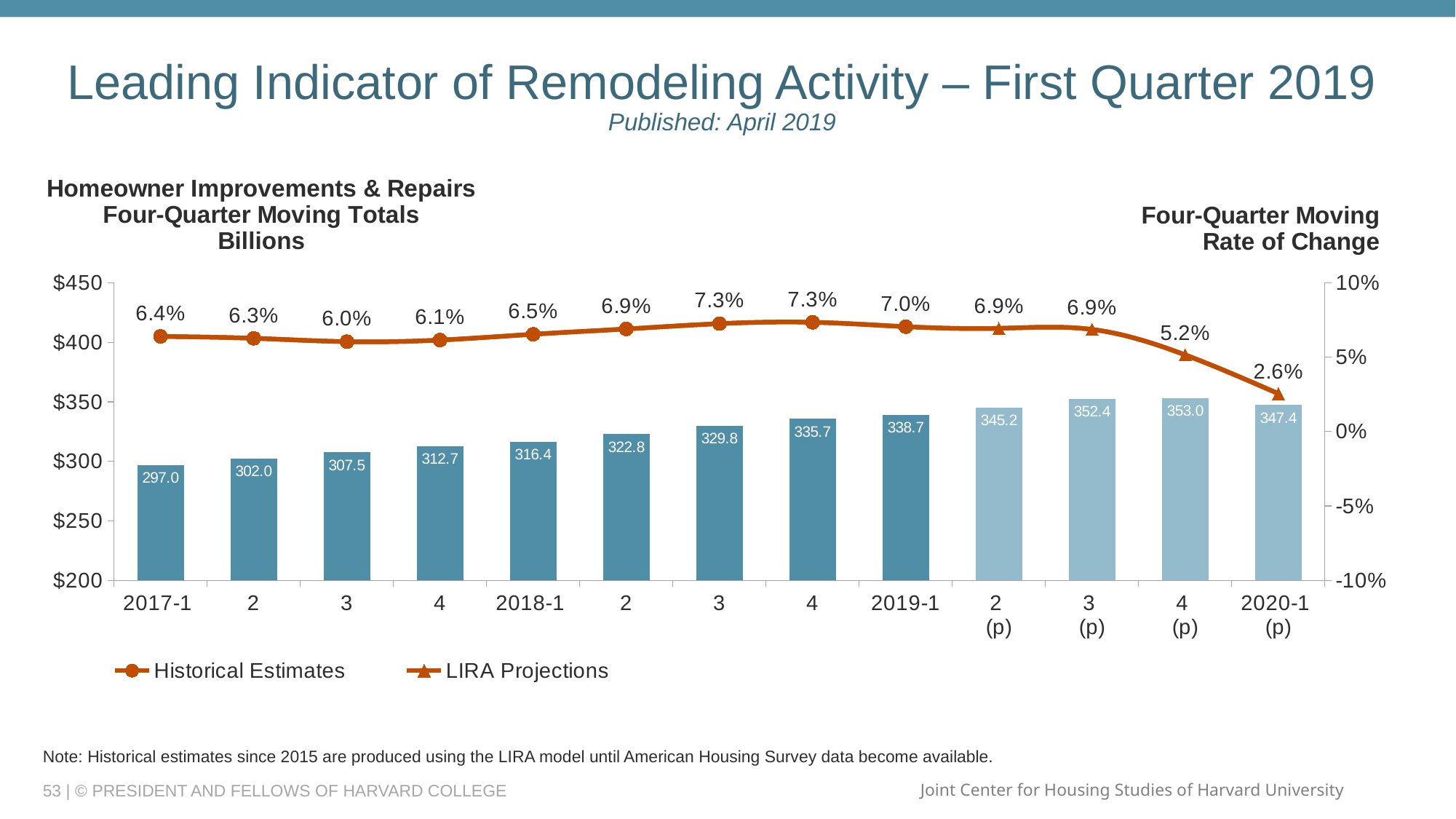
Which period has the lowest four-quarter moving rate of change? 2020-1 (p), 2.6% What is the difference between the rate of change for 2018-4 and 2020-1 (p)? 4.7 percentage points What is the difference between the four-quarter moving totals for 4 (p) and 2020-1 (p)? 5.6 How many series does the legend list? 2 Which is larger, the four-quarter moving total for 2018-2 or for 2019-1? 2019-1 What is the four-quarter moving rate of change for 2018-1? 6.5% What is the projected four-quarter moving total for 2020-1 (p)? 347.4 What kind of chart is this? Combined bar and line chart Which period has the lowest four-quarter moving total bar? 2017-1, 297.0 How many quarterly periods are shown on the x axis? 13 What is the four-quarter moving total (in billions) for 2019-1? 338.7 Which period has the highest four-quarter moving total bar? 4 (p) (2019 Q4 projected), 353.0